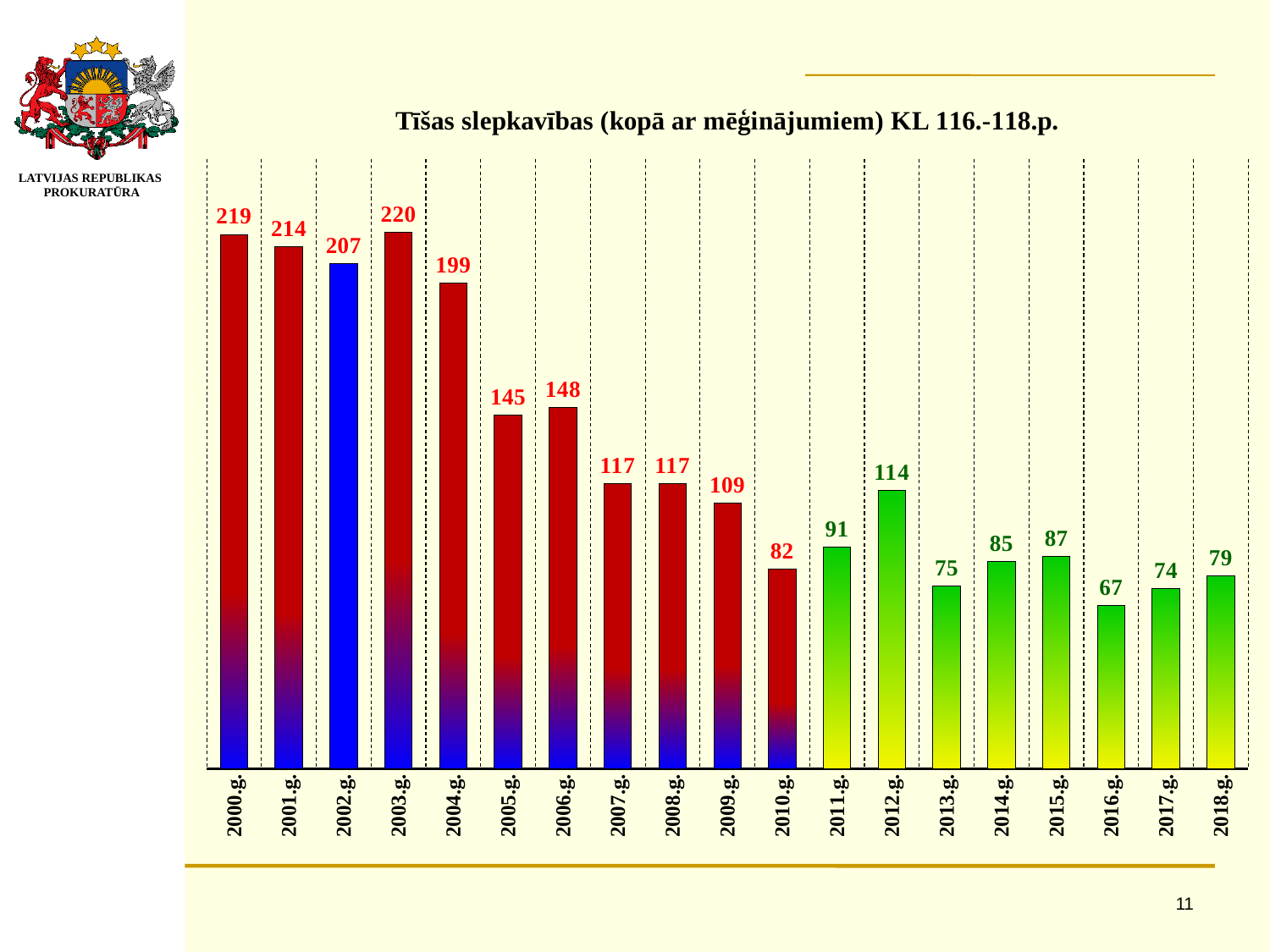
Which is larger, the value for 2011.g. or the value for 2013.g.? 2011.g. What is the title of the chart? Tīšas slepkavības (kopā ar mēģinājumiem) KL 116.-118.p. What kind of chart is this? bar chart What is the difference between the values for 2000.g. and 2018.g.? 140 What is the value for 2012.g.? 114 Do the values generally rise or fall from 2000.g. to 2018.g.? fall What is the value for 2003.g.? 220 Which year has the highest value? 2003.g. Which year's bar is coloured solid blue? 2002.g. What is the value for 2016.g.? 67 Which year has the lowest value? 2016.g. How many years are shown on the x axis? 19